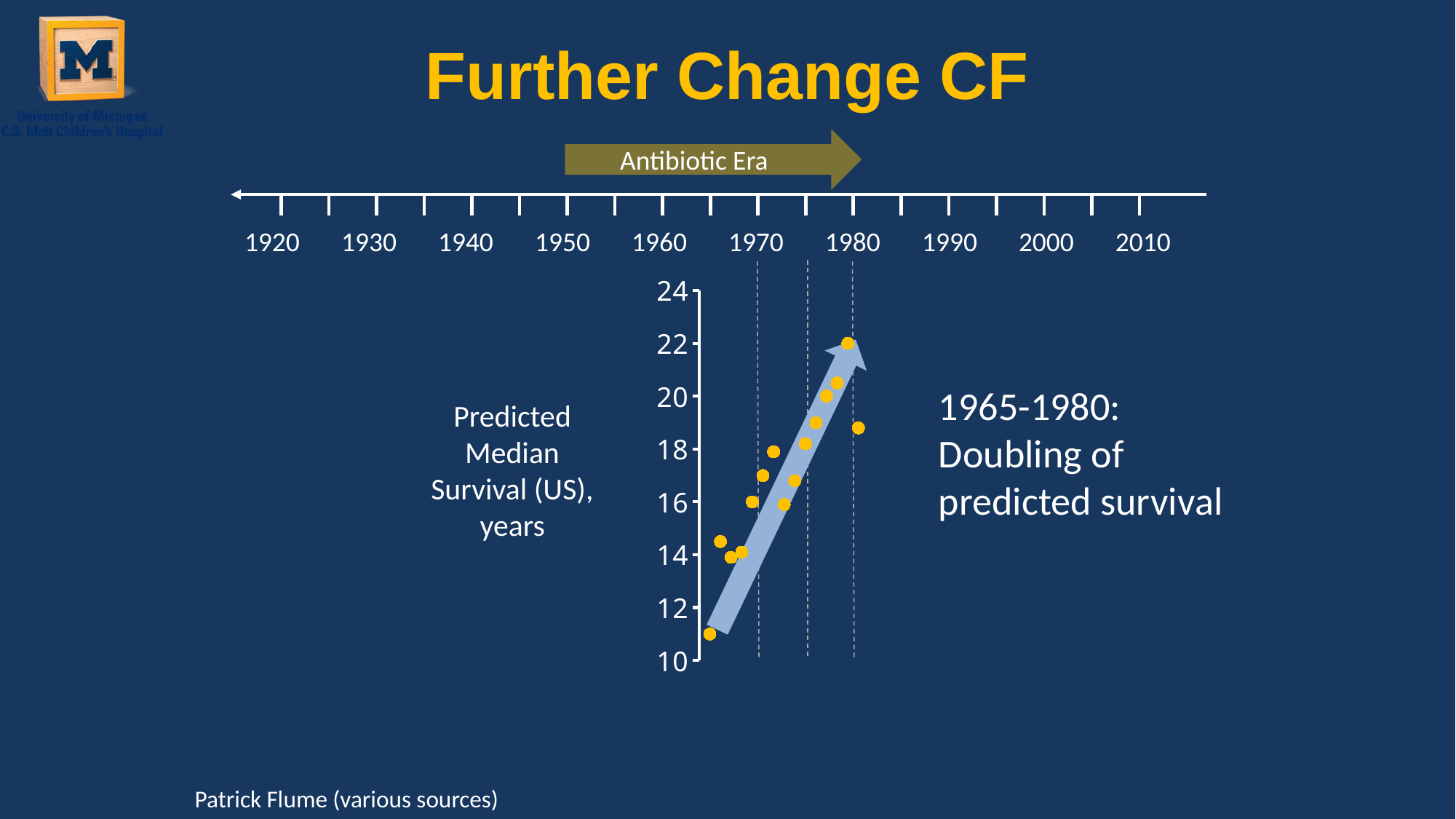
What kind of chart is shown on the slide? scatter plot Do the predicted median survival values rise or fall from 1965 to 1980? rise Is the highest plotted value greater or less than 24 years? less Which is larger: the predicted median survival around 1965 or around 1980? around 1980 Is the earliest plotted value (around 1965) greater or less than 12 years? less How many data points are plotted on the chart? 15 Is the earliest plotted value (around 1965) greater or less than 10 years? greater What is the label of the vertical axis of the chart? Predicted Median Survival (US), years What is the highest tick value shown on the vertical axis? 24